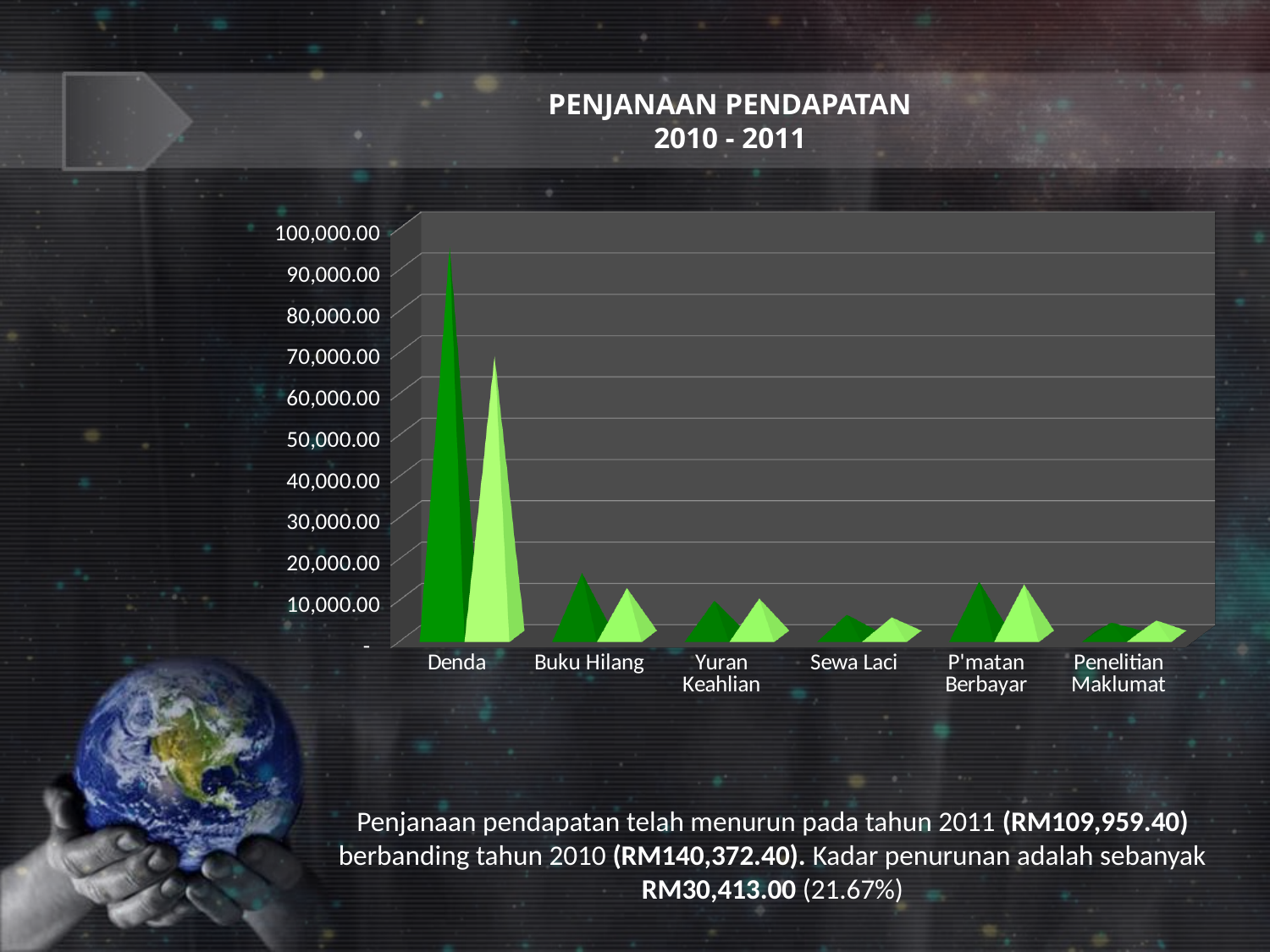
Which category has the highest values in the chart? Denda Is the dark green value for Denda greater or less than 80,000.00? greater Is the dark green value for Buku Hilang greater or less than 10,000.00? greater Is the dark green value for Sewa Laci greater or less than 10,000.00? less According to the text below the chart, what was the total revenue (penjanaan pendapatan) in 2010? RM140,372.40 How many categories are shown on the x axis of the chart? 6 What kind of chart is shown on the slide? bar chart For Denda, which is larger: the dark green bar or the light green bar? the dark green bar What is the title of the chart? PENJANAAN PENDAPATAN 2010 - 2011 Which category has larger values: Buku Hilang or Sewa Laci? Buku Hilang